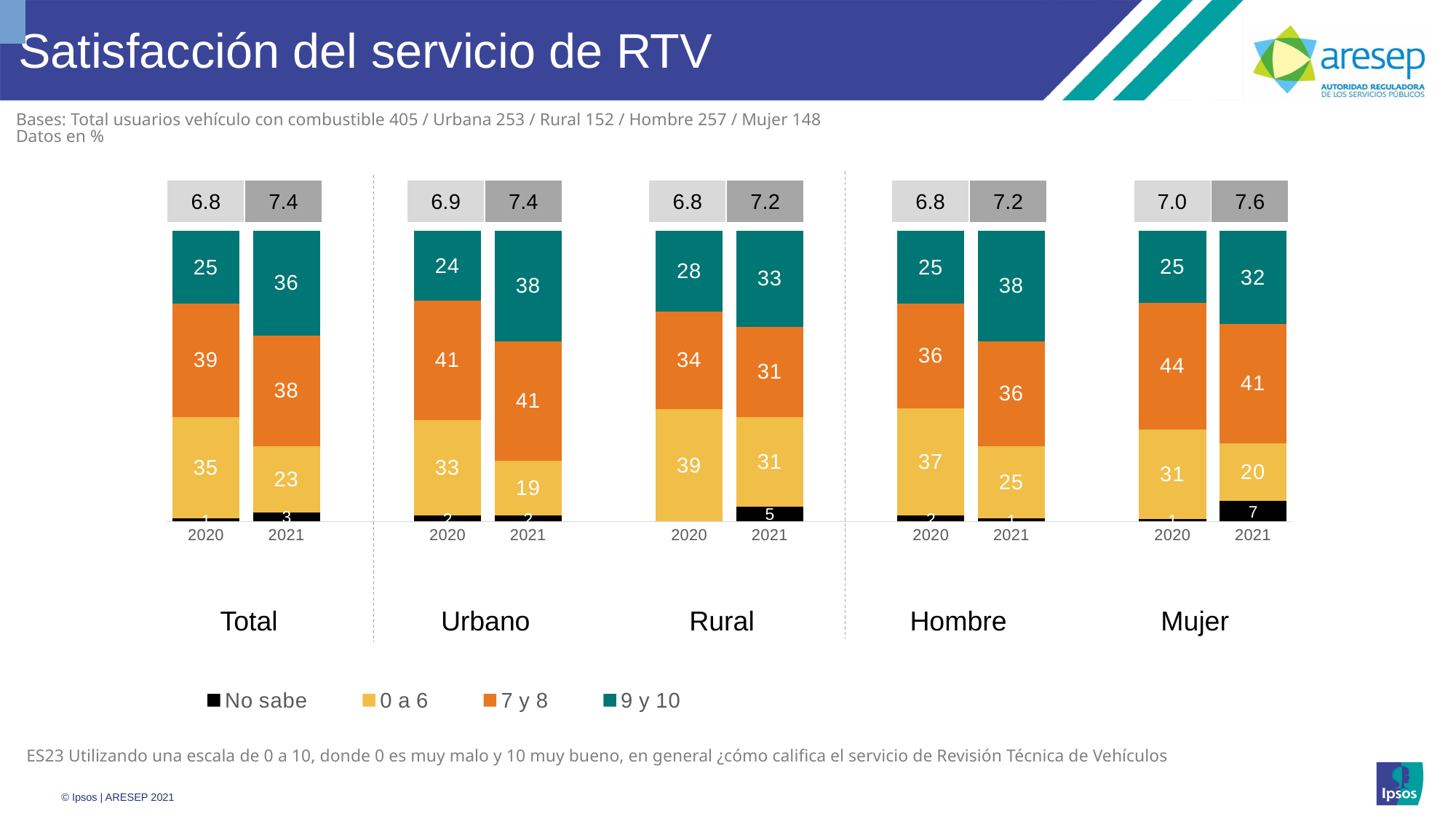
What kind of chart is shown on the slide? Stacked bar chart What is the value of the '0 a 6' segment for Urbano in 2021? 19 What is the value of the '9 y 10' segment for Total in 2021? 36 What is the value of the 'No sabe' segment for Mujer in 2021? 7 Did the '0 a 6' value for Total rise or fall from 2020 to 2021? Fall What is the average score shown above the Mujer 2021 bar? 7.6 Which is larger, the '7 y 8' value for Mujer in 2020 or for Rural in 2020? Mujer 2020 How many series does the legend list? 4 Which colour represents the '9 y 10' series in the legend? Teal What is the difference between the '9 y 10' values for Hombre in 2021 and 2020? 13 What is the total of the stacked bar for Total in 2021? 100 Which group has the highest average score in 2021? Mujer